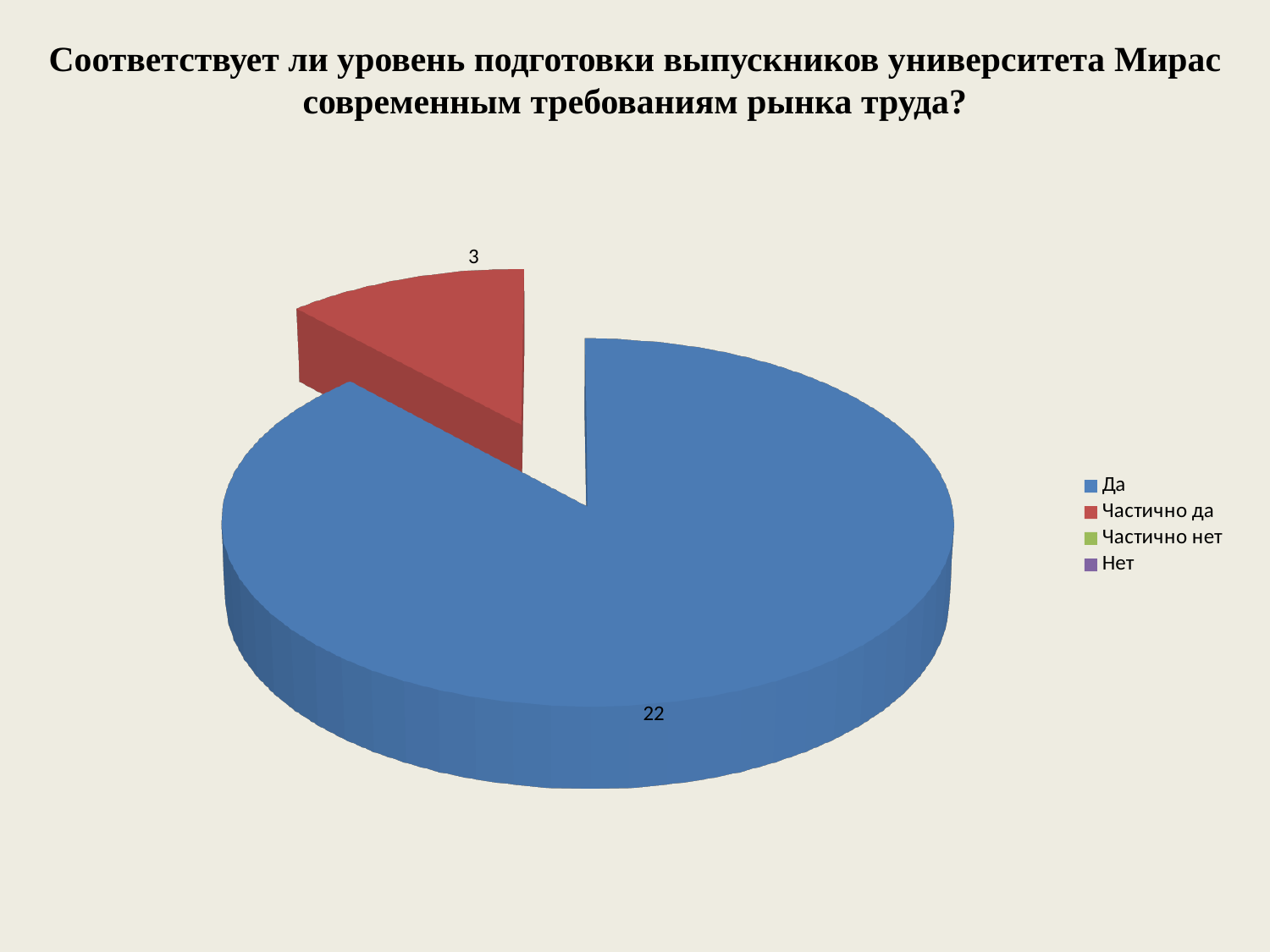
What colour is the "Да" slice? Blue How many slices have data labels printed on the chart? 2 Which legend entry is shown in red? Частично да Which of the labelled slices is the smallest? Частично да How many entries does the legend list? 4 Which is larger, the value for "Да" or the value for "Частично да"? Да Which category has the largest slice of the pie? Да What is the difference between the values for "Да" and "Частично да"? 19 What value is shown for the "Да" slice? 22 What kind of chart is shown on the slide? Pie chart What value is shown for the "Частично да" slice? 3